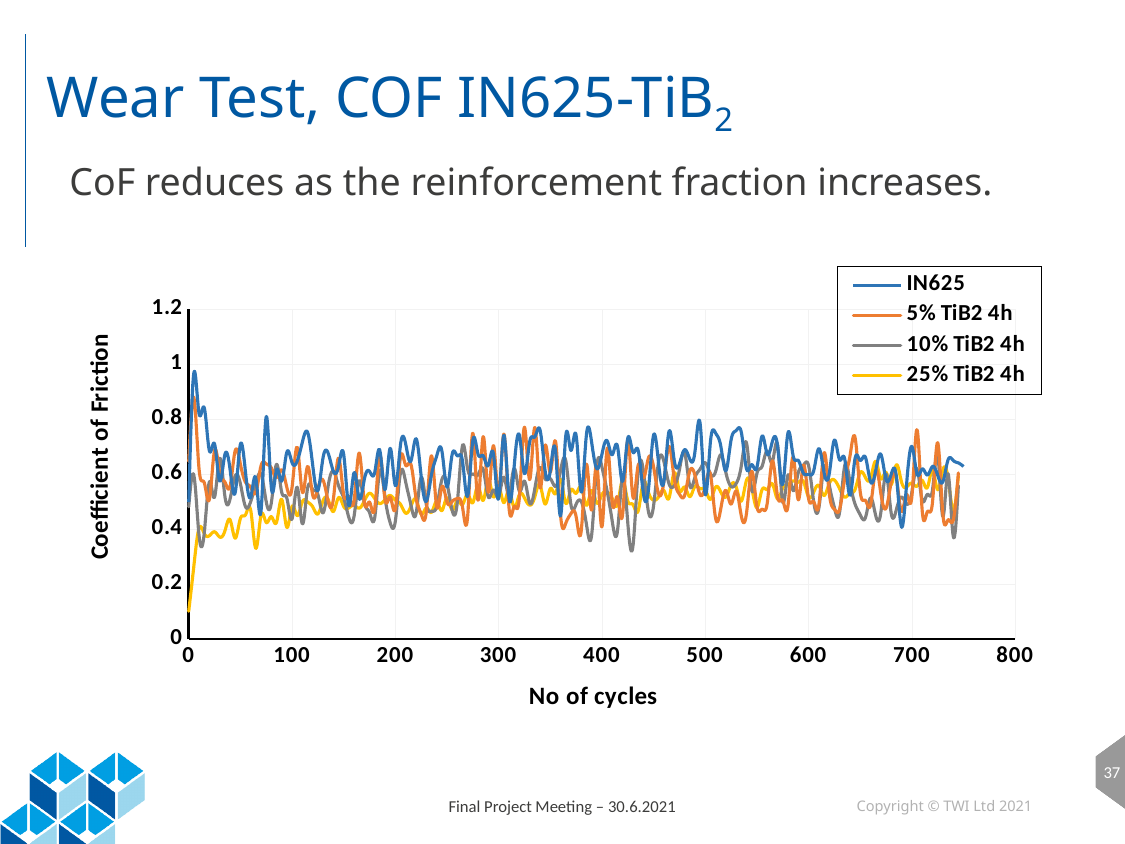
What kind of chart is shown on the slide? line chart What is the highest tick value shown on the y axis? 1.2 Is the lowest value of the 10% TiB2 4h series, around 430 cycles, greater or less than 0.4? less Is the peak value of the IN625 series near the start of the test greater or less than 0.8? greater What is the label of the y axis? Coefficient of Friction Which series generally has the lowest coefficient of friction across the test? 25% TiB2 4h Which series reaches the highest coefficient of friction value on the chart? IN625 Is the starting value of the 25% TiB2 4h series at 0 cycles greater or less than 0.2? less How many series does the legend list? 4 What are the four series listed in the legend? IN625, 5% TiB2 4h, 10% TiB2 4h, 25% TiB2 4h Does the 25% TiB2 4h series rise or fall over the first 100 cycles? rise